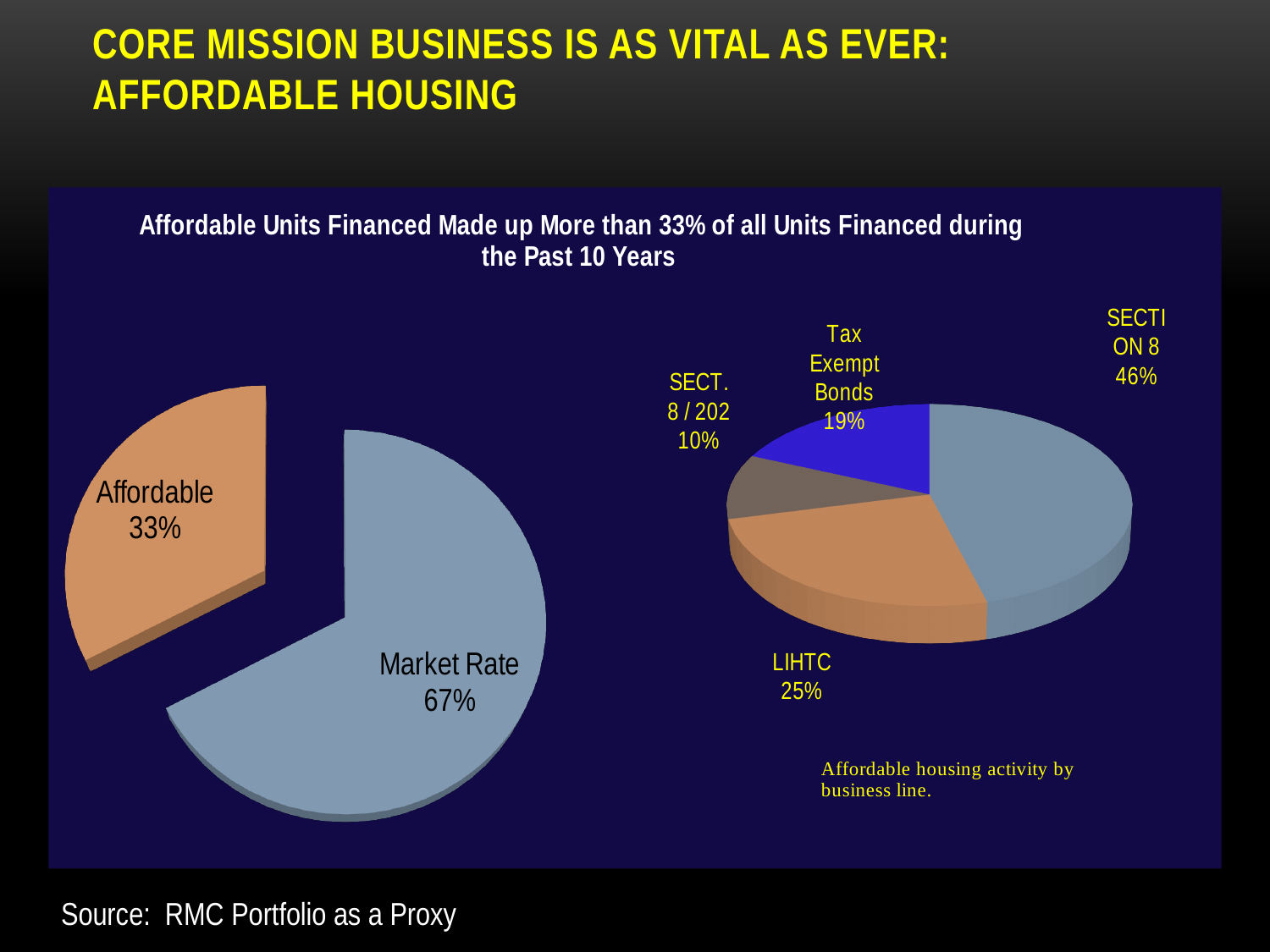
What type of chart is shown on the left side of the slide? Pie chart On the left pie chart, what is the difference in percentage points between Market Rate and Affordable? 34 On the left pie chart, what share of units financed is Affordable? 33% On the right pie chart, which business line has the smallest share? Sect. 8 / 202 On the right pie chart, what share is LIHTC? 25% On the right pie chart, what share is Sect. 8 / 202? 10% On the left pie chart, which slice is larger, Affordable or Market Rate? Market Rate On the left pie chart, what share of units financed is Market Rate? 67% On the right pie chart, what share is Tax Exempt Bonds? 19% How many slices does the right pie chart have? 4 On the right pie chart, which business line has the largest share? Section 8 On the right pie chart (affordable housing activity by business line), what share is Section 8? 46%